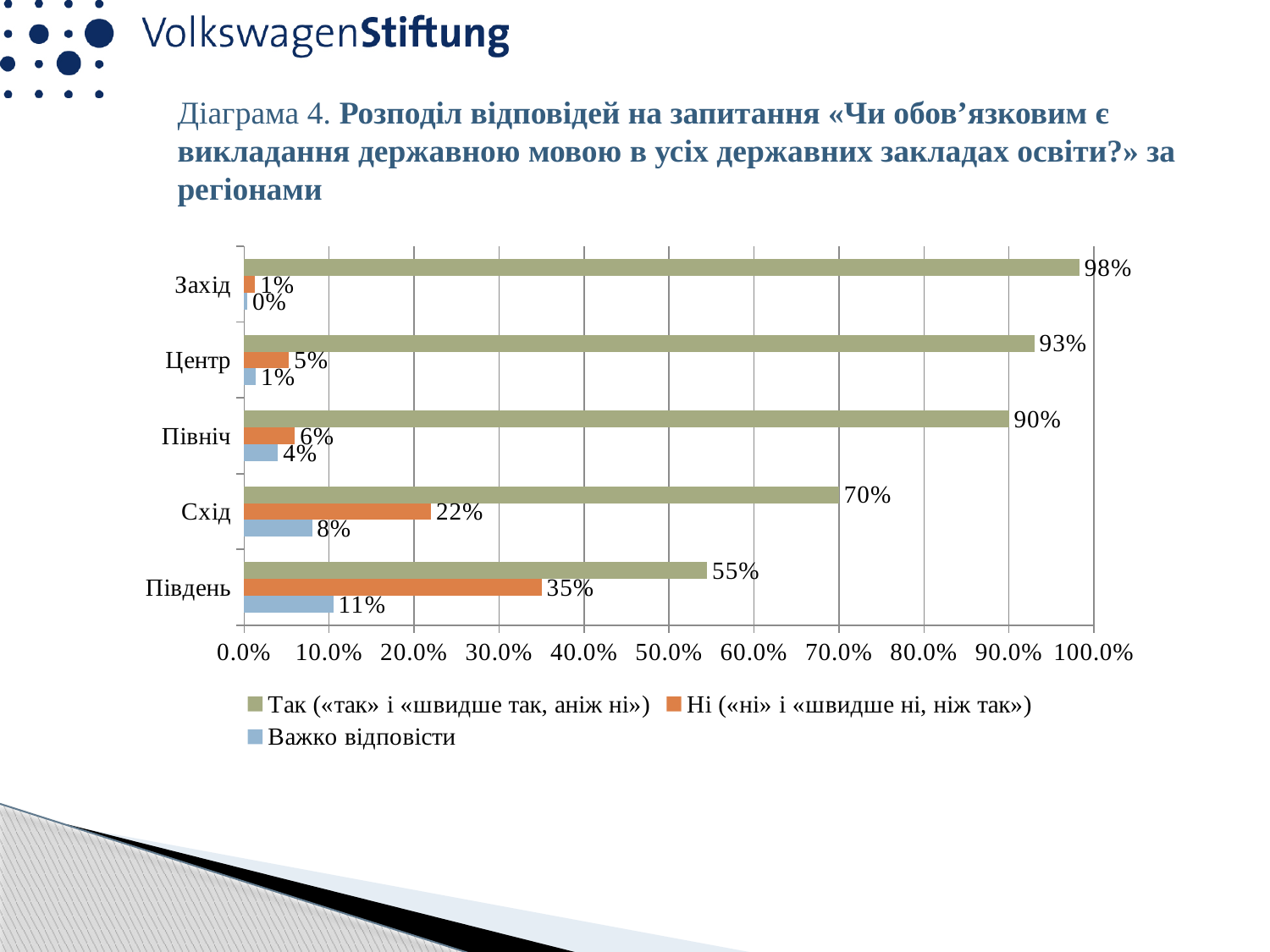
Which region has the lowest value in the series Так («так» і «швидше так, аніж ні»)? Південь Which region has the highest value in the series Так («так» і «швидше так, аніж ні»)? Захід How many regions are shown on the chart? 5 What is the difference between the Так values for Захід and Південь? 43% What is the value for Захід in the series Так («так» і «швидше так, аніж ні»)? 98% What is the value for Схід in the series Важко відповісти? 8% What is the value for Центр in the series Важко відповісти? 1% Is the Так value for Схід greater or less than 60.0%? greater What is the value for Південь in the series Ні («ні» і «швидше ні, ніж так»)? 35% What kind of chart is shown on the slide? bar chart Which is larger: the Ні value for Схід or the Ні value for Північ? Схід How many series does the legend list? 3